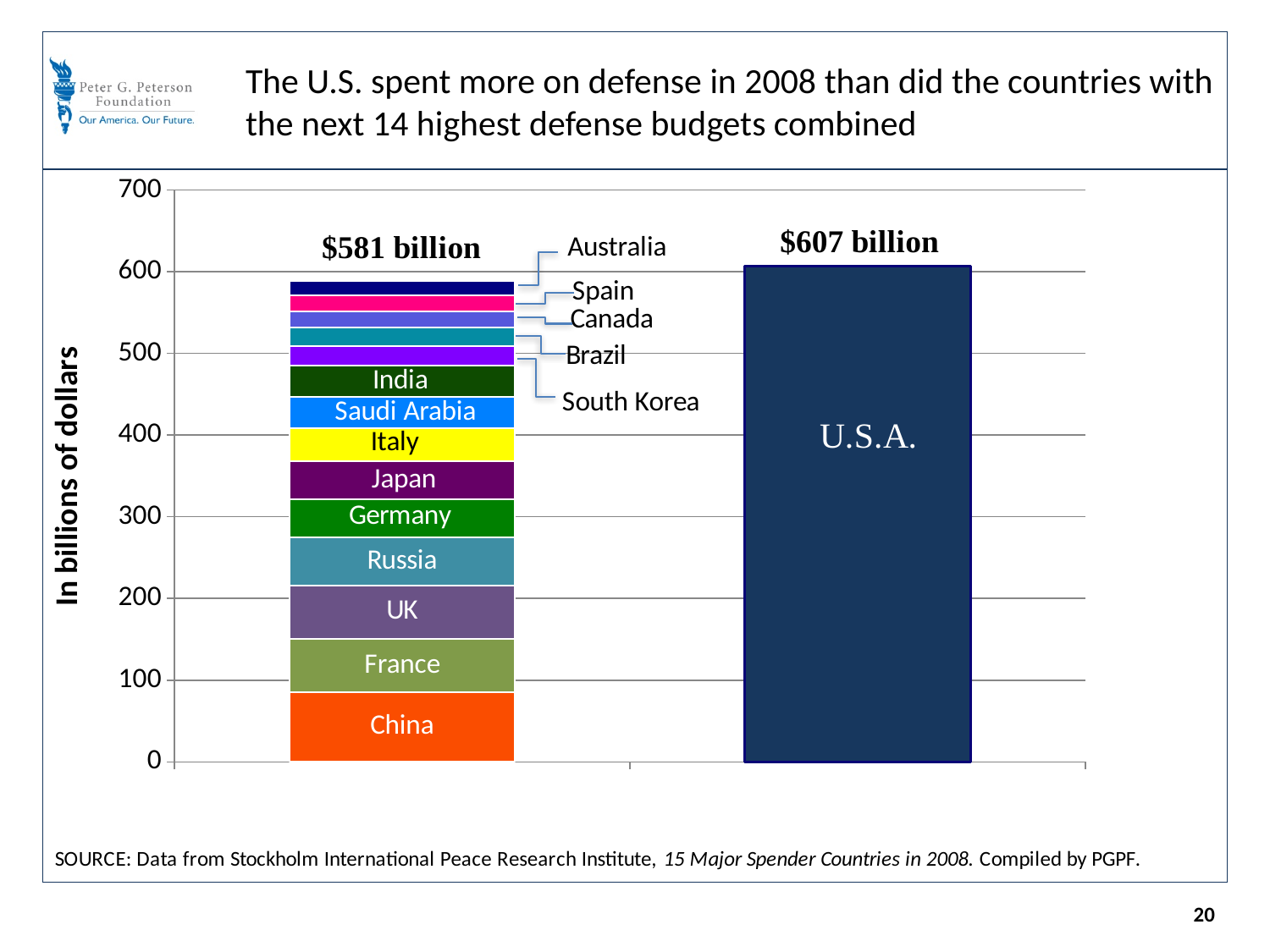
Is the combined value of the 14 countries greater or less than 600? less Which country forms the bottom segment of the stacked bar? China Which is larger: the U.S.A. bar or the combined bar of the next 14 countries? U.S.A. Is the value for China greater or less than 100? less What is the difference between the U.S.A. bar and the combined bar of the other 14 countries? $26 billion What is the total value of the stacked bar representing the 14 countries combined? $581 billion Which country forms the top segment of the stacked bar? Australia Which country has the largest segment in the stacked bar? China How many countries are stacked in the combined bar? 14 Is the value for the U.S.A. greater or less than 600? greater What is the value shown for the U.S.A. bar? $607 billion What kind of chart is shown on the slide? Stacked bar chart